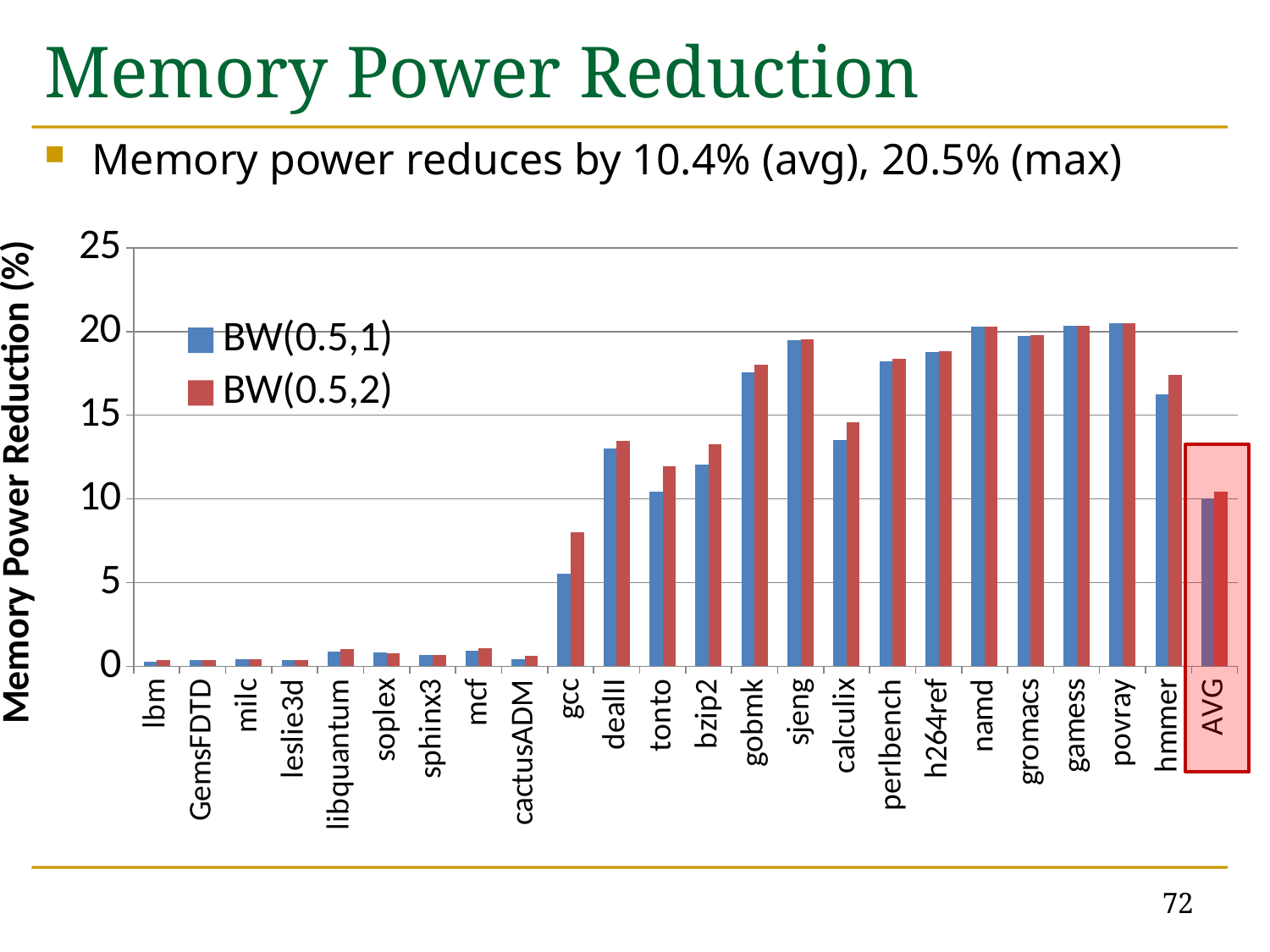
Do the values generally rise or fall moving from left to right along the x axis? rise How many series does the legend list? 2 Is the BW(0.5,2) value for gcc greater or less than 5? greater What kind of chart is shown on the slide? bar chart What is the label of the y axis? Memory Power Reduction (%) For gcc, which series has the larger value, BW(0.5,1) or BW(0.5,2)? BW(0.5,2) Is the BW(0.5,1) value for hmmer greater or less than 15? greater Is the BW(0.5,1) value for calculix greater or less than 15? less What are the two series named in the legend? BW(0.5,1) and BW(0.5,2) How many categories are shown along the x axis? 24